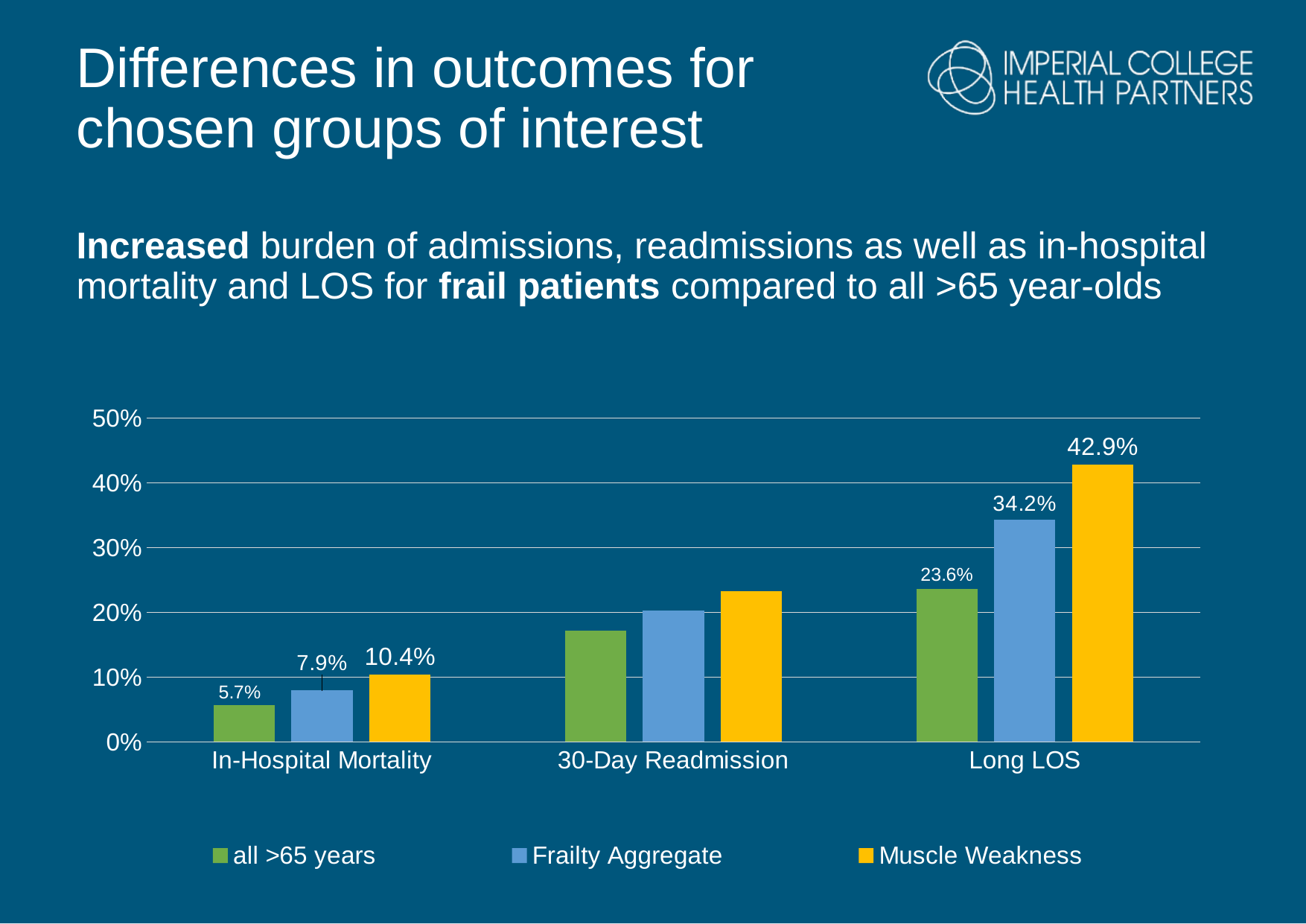
What is the value for Frailty Aggregate in the In-Hospital Mortality category? 7.9% In the Long LOS category, how much higher is the Muscle Weakness value than the all >65 years value? 19.3 percentage points What is the value for all >65 years in the In-Hospital Mortality category? 5.7% How many series does the chart legend list? 3 Which category has the highest value for the Muscle Weakness series? Long LOS What is the value for Frailty Aggregate in the Long LOS category? 34.2% What is the value for Muscle Weakness in the Long LOS category? 42.9% In the In-Hospital Mortality category, what is the difference between the Muscle Weakness value and the all >65 years value? 4.7 percentage points Is the value for all >65 years in the 30-Day Readmission category greater or less than 20%? less How many outcome categories are shown on the x axis of the chart? 3 Is the value for Muscle Weakness in the 30-Day Readmission category greater or less than 20%? greater In the 30-Day Readmission category, which is larger: the Frailty Aggregate value or the all >65 years value? Frailty Aggregate